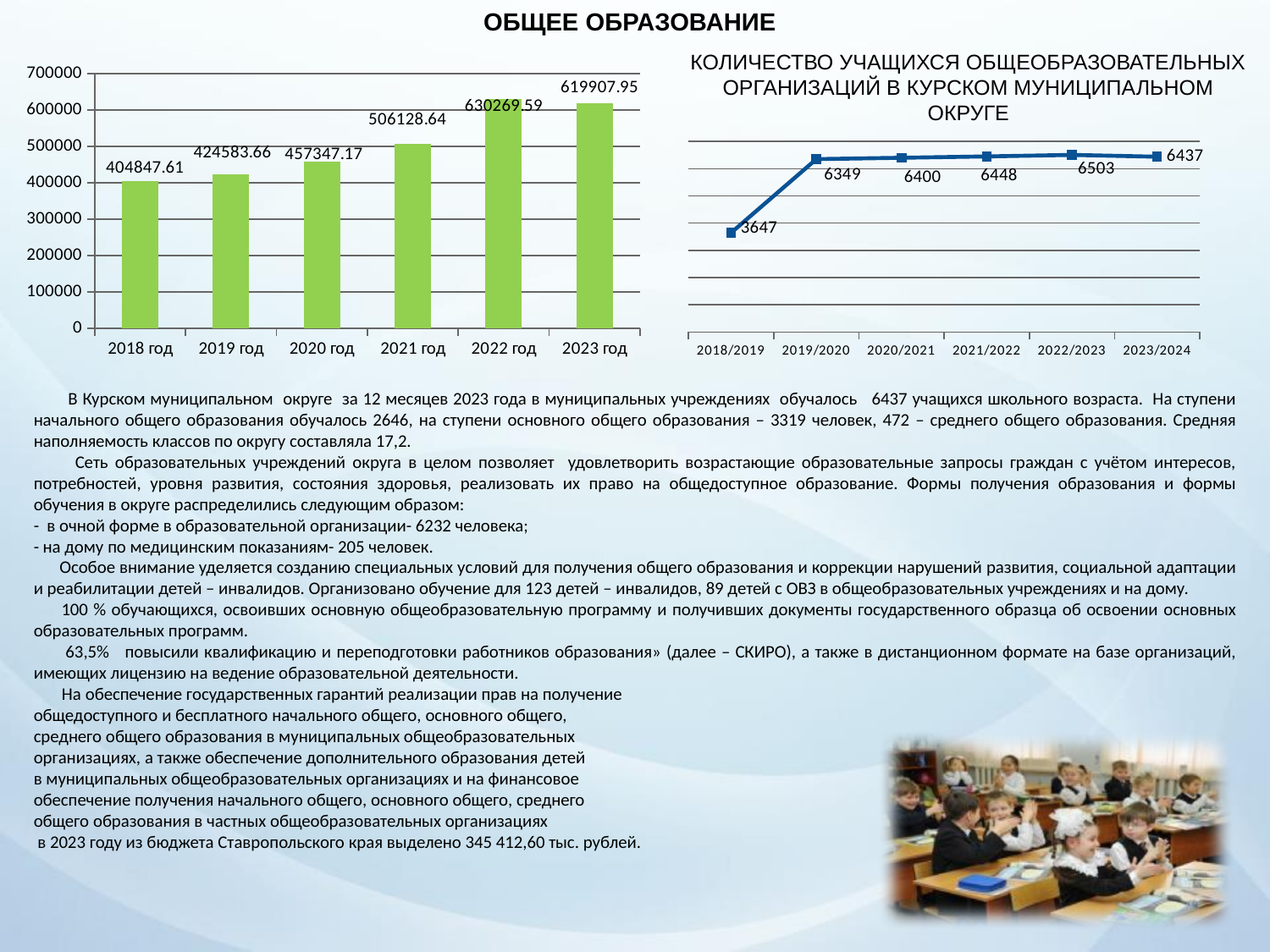
What kind of chart is the chart on the left of the slide? bar chart In the bar chart on the left, which year has the highest value? 2022 год In the line chart titled 'КОЛИЧЕСТВО УЧАЩИХСЯ ОБЩЕОБРАЗОВАТЕЛЬНЫХ ОРГАНИЗАЦИЙ В КУРСКОМ МУНИЦИПАЛЬНОМ ОКРУГЕ', which school year has the highest value? 2022/2023 In the line chart titled 'КОЛИЧЕСТВО УЧАЩИХСЯ ОБЩЕОБРАЗОВАТЕЛЬНЫХ ОРГАНИЗАЦИЙ В КУРСКОМ МУНИЦИПАЛЬНОМ ОКРУГЕ', what is the difference between the values for 2019/2020 and 2018/2019? 2702 In the line chart titled 'КОЛИЧЕСТВО УЧАЩИХСЯ ОБЩЕОБРАЗОВАТЕЛЬНЫХ ОРГАНИЗАЦИЙ В КУРСКОМ МУНИЦИПАЛЬНОМ ОКРУГЕ', which is larger: the value for 2020/2021 or 2021/2022? 2021/2022 In the bar chart on the left, what is the value for 2018 год? 404847.61 In the line chart titled 'КОЛИЧЕСТВО УЧАЩИХСЯ ОБЩЕОБРАЗОВАТЕЛЬНЫХ ОРГАНИЗАЦИЙ В КУРСКОМ МУНИЦИПАЛЬНОМ ОКРУГЕ', what is the value for 2018/2019? 3647 In the bar chart on the left, what is the value for 2021 год? 506128.64 In the bar chart on the left, which year has the lowest value? 2018 год In the bar chart on the left, what is the difference between the values for 2022 год and 2023 год? 10361.64 In the line chart titled 'КОЛИЧЕСТВО УЧАЩИХСЯ ОБЩЕОБРАЗОВАТЕЛЬНЫХ ОРГАНИЗАЦИЙ В КУРСКОМ МУНИЦИПАЛЬНОМ ОКРУГЕ', what is the value for 2023/2024? 6437 In the bar chart on the left, how many years are shown? 6